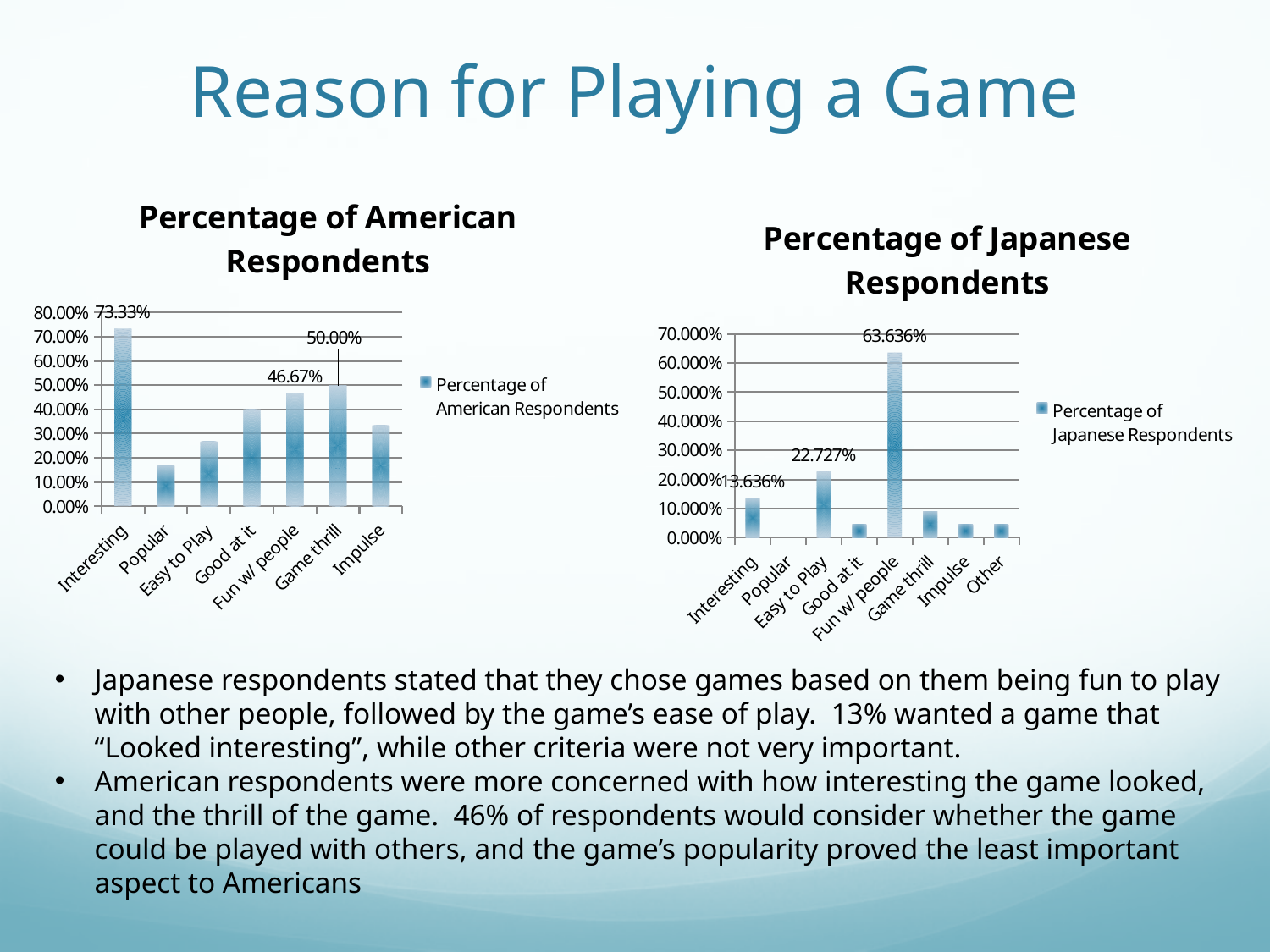
In the Percentage of Japanese Respondents chart, what is the value for Fun w/ people? 63.636% In the Percentage of American Respondents chart, which category has the lowest value? Popular In the Percentage of Japanese Respondents chart, which category has the highest value? Fun w/ people In the Percentage of Japanese Respondents chart, what is the value for Easy to Play? 22.727% In the Percentage of American Respondents chart, what is the value for Interesting? 73.33% In the Percentage of Japanese Respondents chart, which is larger, the value for Interesting or the value for Easy to Play? Easy to Play What kind of chart is the Percentage of American Respondents chart? bar chart In the Percentage of American Respondents chart, which category has the highest value? Interesting In the Percentage of American Respondents chart, what is the difference between the values for Game thrill and Fun w/ people? 3.33% How many categories are shown on the x axis of the Percentage of Japanese Respondents chart? 8 In the Percentage of American Respondents chart, is the value for Good at it greater or less than 30.00%? greater In the Percentage of American Respondents chart, what is the value for Game thrill? 50.00%